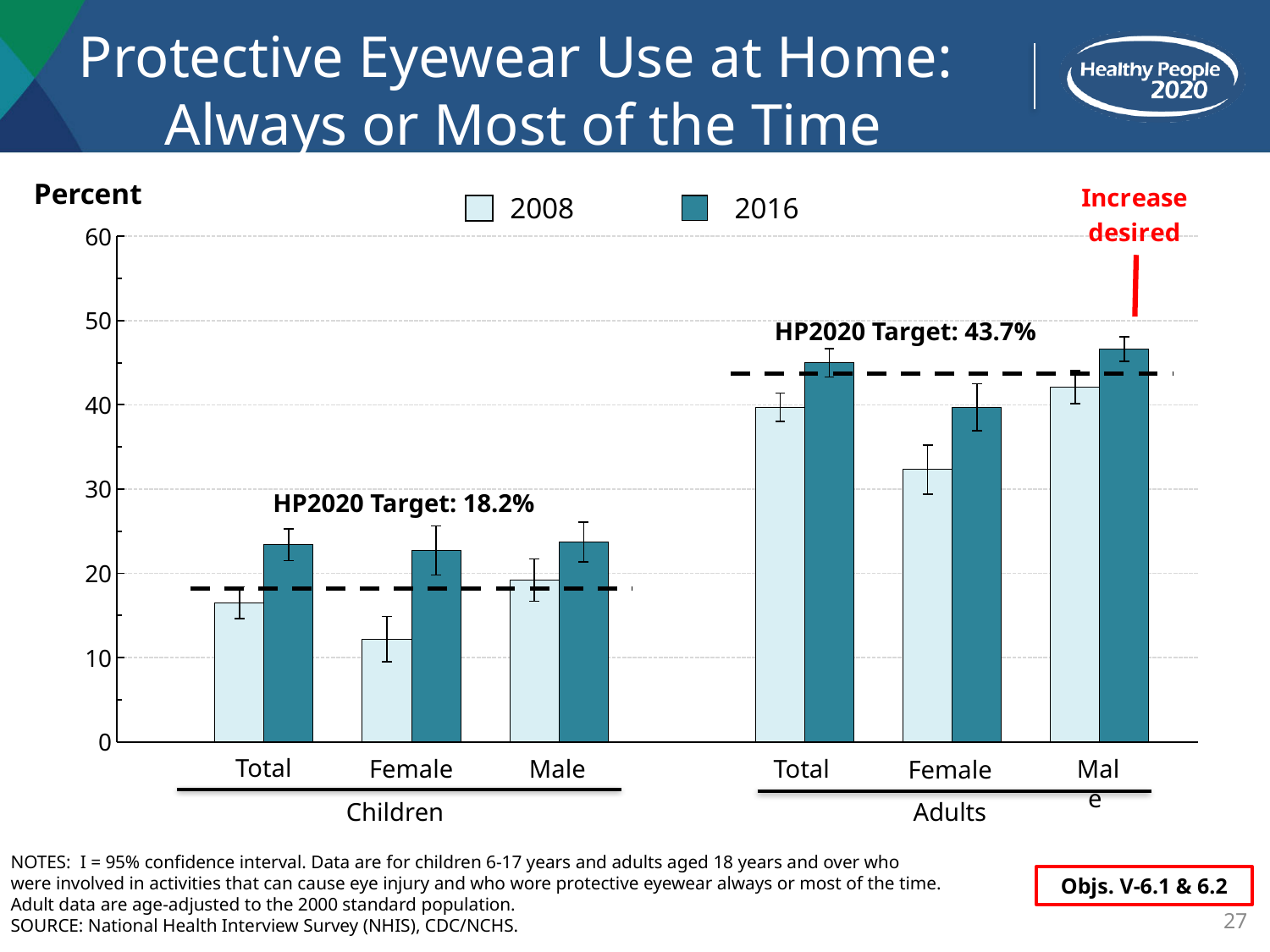
What is the HP2020 target for children shown on the chart? 18.2% For adults in 2008, which is larger: the Total value or the Female value? Total What is the HP2020 target for adults shown on the chart? 43.7% What kind of chart is shown on the slide? bar chart Is the 2016 value for Total adults greater or less than 40? greater Is the 2008 value for Female children greater or less than 20? less Within each category, is the 2016 value higher or lower than the 2008 value? higher How many category groups (bar pairs) are plotted along the x axis? 6 Is the 2016 value for Total children greater or less than 20? greater Which bar is the lowest on the chart? Female children, 2008 How many series does the legend list? 2 Which two years are shown in the legend? 2008 and 2016